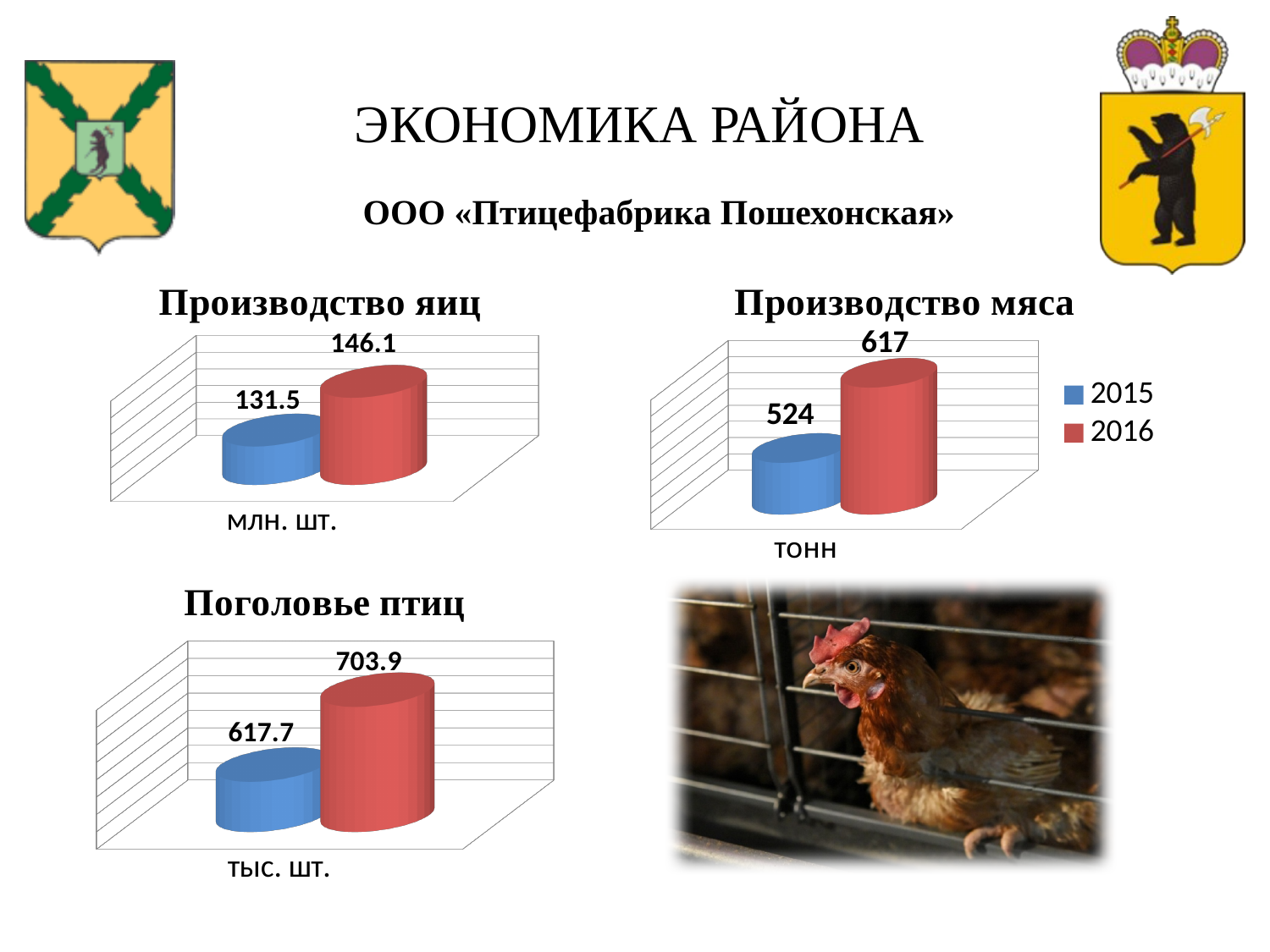
In the chart titled «Поголовье птиц», what is the value for 2015? 617.7 In the chart titled «Производство мяса», what is the value for 2016? 617 In the chart titled «Поголовье птиц», what is the difference between the 2016 and 2015 values? 86.2 In the chart titled «Производство яиц», what is the value for 2015? 131.5 How many series does the legend next to the chart titled «Производство мяса» list? 2 In the chart titled «Поголовье птиц», which year has the higher value, 2015 or 2016? 2016 In the chart titled «Производство яиц», what is the difference between the 2016 and 2015 values? 14.6 In the chart titled «Производство яиц», what is the value for 2016? 146.1 What unit label is shown below the chart titled «Производство мяса»? тонн What kind of chart is the chart titled «Производство яиц»? bar chart In the chart titled «Производство мяса», which year has the lowest value? 2015 In the chart titled «Производство мяса», what is the difference between the 2016 and 2015 values? 93